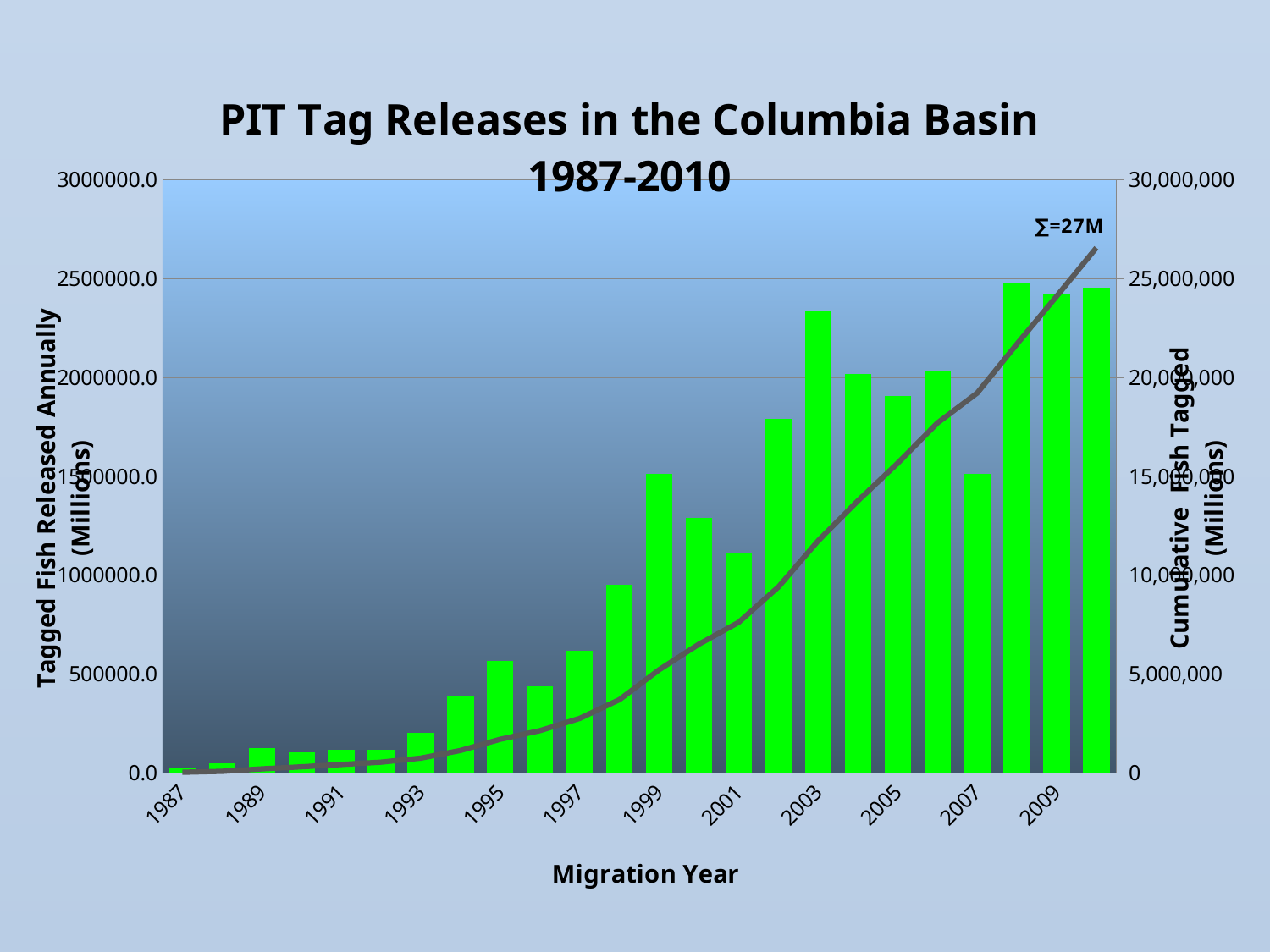
What kind of chart is shown on the slide? A bar chart with a line What is the label of the x axis? Migration Year Is the value for tagged fish released annually in 2007 greater or less than 2000000.0? less Which year has the larger bar for tagged fish released annually, 2003 or 2005? 2003 What cumulative total is annotated at the end of the cumulative fish tagged line? ∑=27M What is the title of the chart? PIT Tag Releases in the Columbia Basin 1987-2010 Is the value for tagged fish released annually in 1993 greater or less than 500000.0? less How many bars (migration years) are plotted in the chart? 24 Does the cumulative fish tagged line rise or fall from 1987 to 2010? Rises Is the value for tagged fish released annually in 1999 greater or less than 1000000.0? greater Which migration year has the lowest bar for tagged fish released annually? 1987